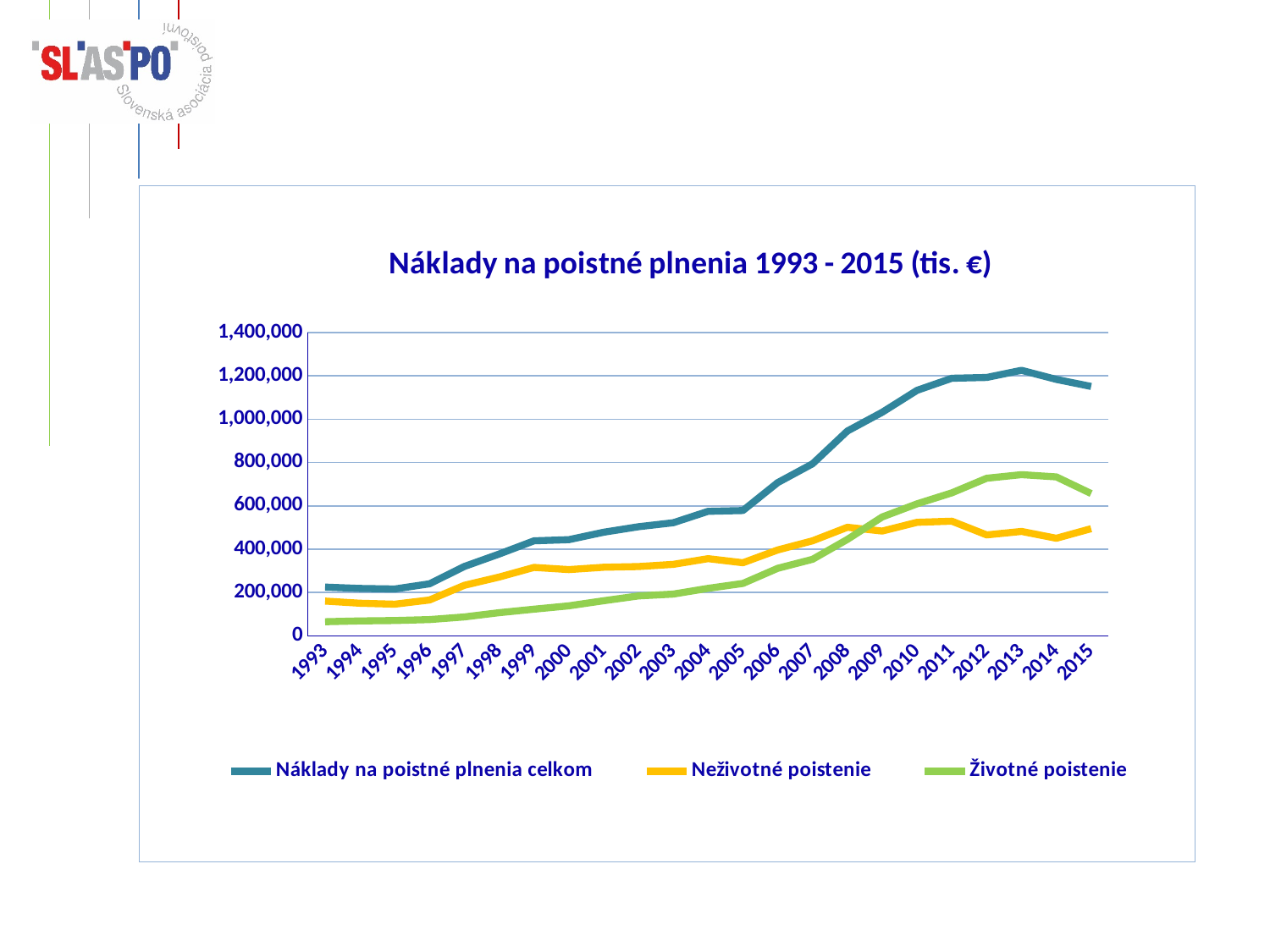
Is the value for Neživotné poistenie in 2013 greater or less than 600,000? less Is the value for Životné poistenie in 2000 greater or less than 200,000? less What is the title of the chart? Náklady na poistné plnenia 1993 - 2015 (tis. €) Does the Životné poistenie series generally rise or fall from 1993 to 2013? rise What kind of chart is shown on the slide? line chart Is the value for Náklady na poistné plnenia celkom in 2008 greater or less than 1,000,000? less Which series is drawn in green? Životné poistenie How many series does the legend list? 3 In 2015, which series has the larger value: Neživotné poistenie or Životné poistenie? Životné poistenie In which year does the series Náklady na poistné plnenia celkom reach its highest value? 2013 How many years are plotted along the x axis? 23